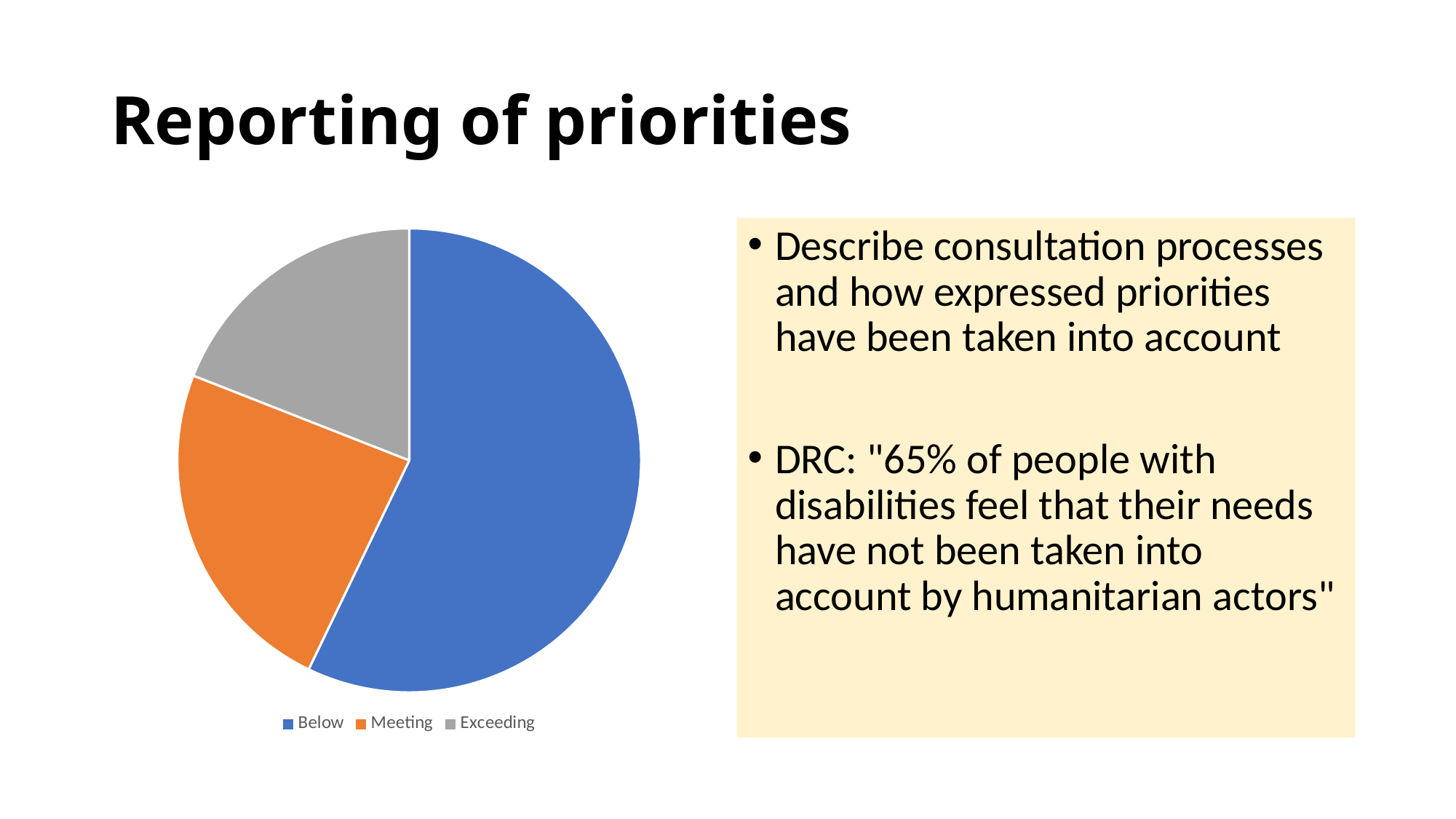
What colour is the Meeting slice in the pie chart? Orange Which category has the smallest slice of the pie chart? Exceeding Which slice is larger in the pie chart, Meeting or Exceeding? Meeting How many entries does the legend of the pie chart list? 3 What are the three categories listed in the legend of the pie chart? Below, Meeting, Exceeding Which category has the largest slice of the pie chart? Below Which slice is larger in the pie chart, Exceeding or Below? Below How many slices does the pie chart have? 3 Which slice is larger in the pie chart, Below or Meeting? Below What kind of chart is shown on the slide? Pie chart